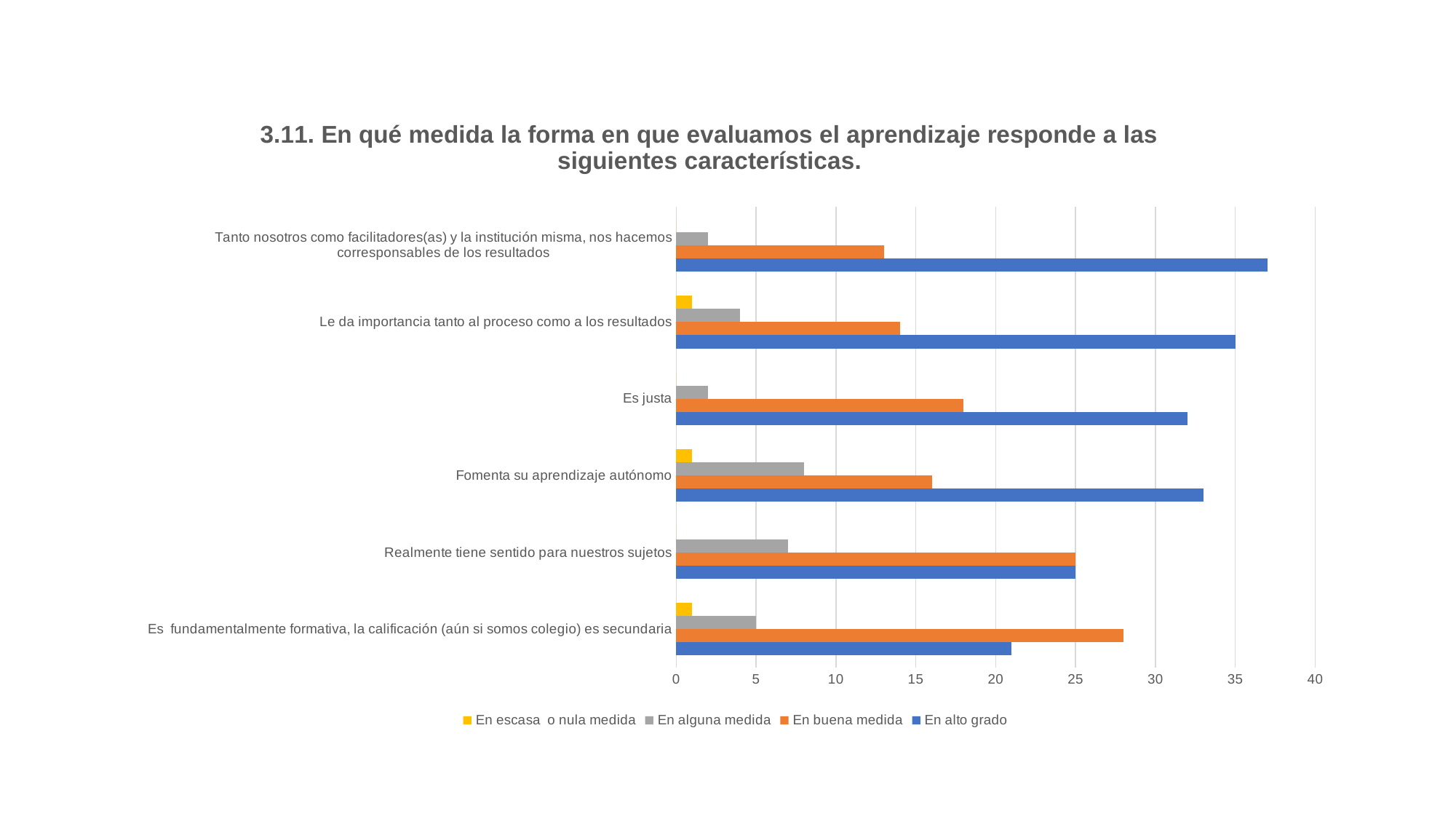
Which category has the lowest value for the 'En alto grado' series? Es fundamentalmente formativa, la calificación (aún si somos colegio) es secundaria What kind of chart is shown on the slide? bar chart How many categories (characteristics) are plotted on the chart? 6 Is the 'En alto grado' value for 'Es fundamentalmente formativa, la calificación (aún si somos colegio) es secundaria' greater or less than 25? less Which category has the highest value for the 'En buena medida' series? Es fundamentalmente formativa, la calificación (aún si somos colegio) es secundaria For 'Es fundamentalmente formativa, la calificación (aún si somos colegio) es secundaria', which is larger: the 'En buena medida' value or the 'En alto grado' value? En buena medida Is the 'En alto grado' value for 'Es justa' greater or less than 30? greater Is the 'En alto grado' value for 'Tanto nosotros como facilitadores(as) y la institución misma, nos hacemos corresponsables de los resultados' greater or less than 35? greater Which series is shown in blue in the legend? En alto grado Which category has the highest value for the 'En alto grado' series? Tanto nosotros como facilitadores(as) y la institución misma, nos hacemos corresponsables de los resultados How many series does the legend list? 4